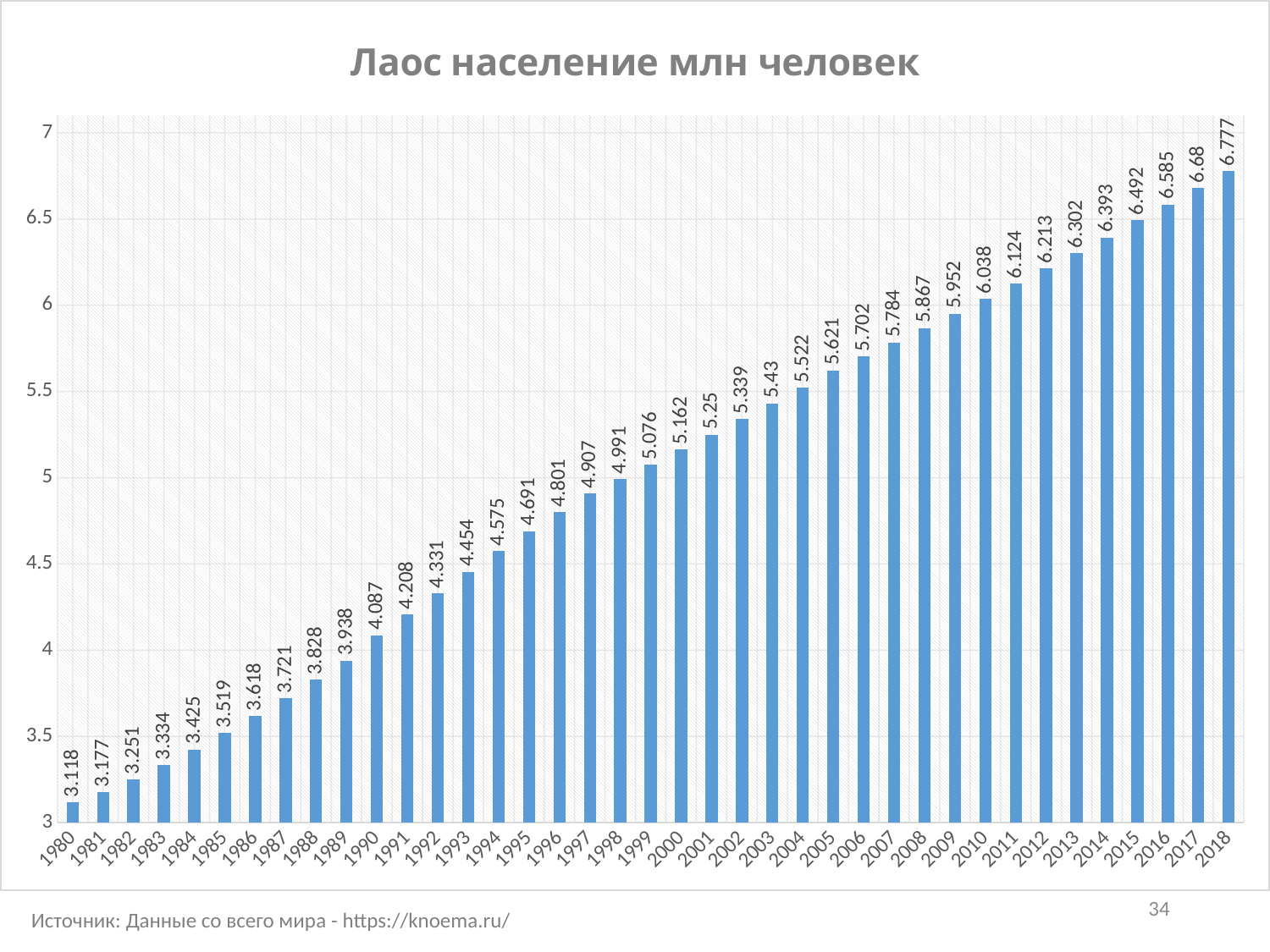
Which year has the lowest population value? 1980 What is the population value shown for 2018? 6.777 What kind of chart is shown on the slide? Bar chart What is the population value shown for 2000? 5.162 What is the difference between the population values for 2000 and 1990? 1.075 What is the population value shown for 1995? 4.691 Which year has the highest population value? 2018 What is the difference between the population values for 2018 and 1980? 3.659 Which is larger, the population value for 2005 or for 1985? 2005 Do the population values rise or fall from 1980 to 2018? Rise What is the population value shown for 1980? 3.118 How many years are shown on the x axis? 39